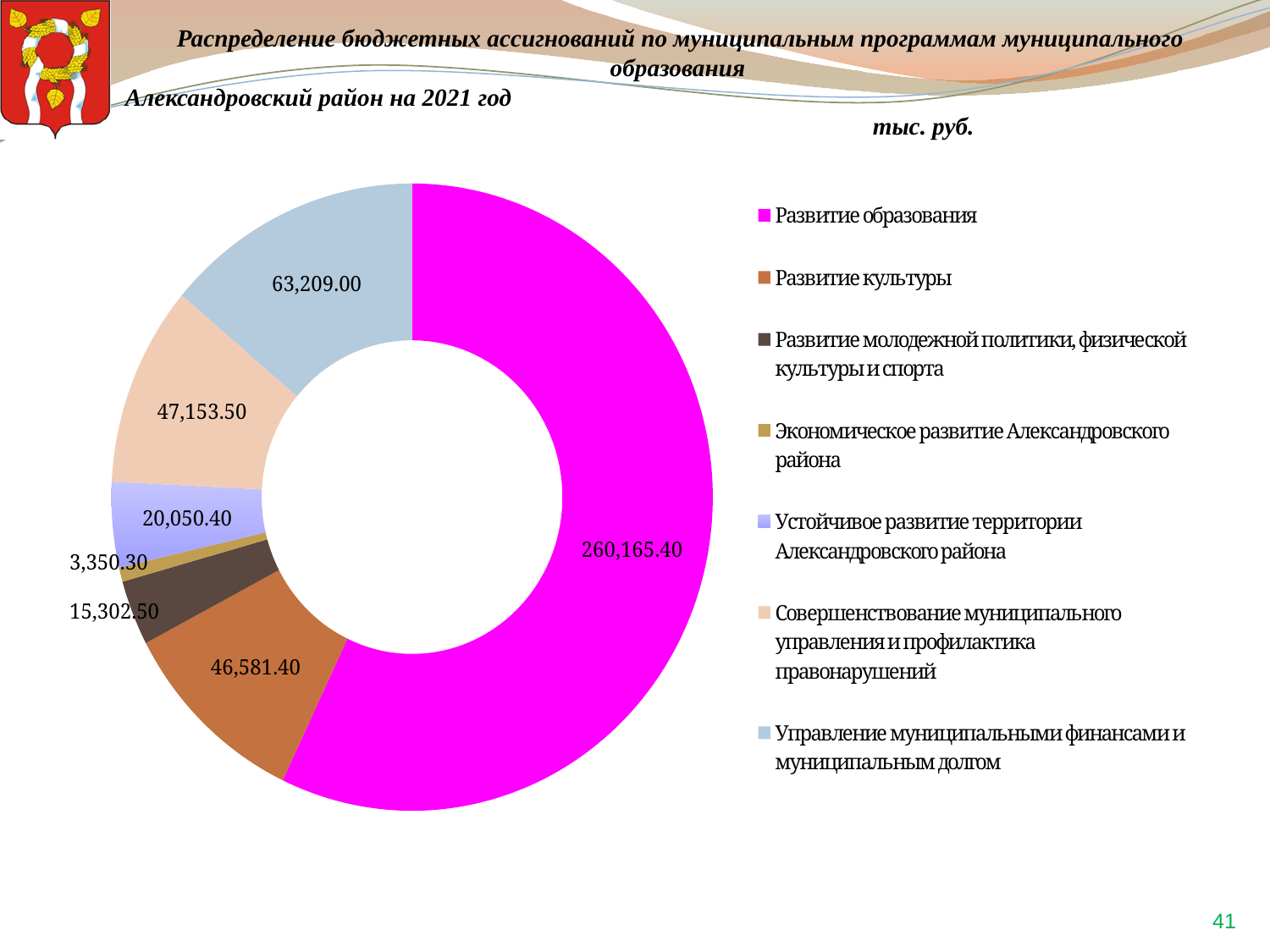
Which is larger: the value for Устойчивое развитие территории Александровского района or the value for Развитие молодежной политики, физической культуры и спорта? Устойчивое развитие территории Александровского района What is the value for Устойчивое развитие территории Александровского района? 20,050.40 What is the value for Управление муниципальными финансами и муниципальным долгом? 63,209.00 What is the value for Развитие культуры? 46,581.40 What is the value for Развитие образования? 260,165.40 What is the value for Экономическое развитие Александровского района? 3,350.30 What unit of measurement is indicated for the chart values? тыс. руб. How many programs (slices) are shown in the chart? 7 What is the difference between the values for Управление муниципальными финансами и муниципальным долгом and Совершенствование муниципального управления и профилактика правонарушений? 16,055.50 Which program has the smallest budget allocation? Экономическое развитие Александровского района What kind of chart is shown on the slide? doughnut chart Which program has the largest budget allocation? Развитие образования